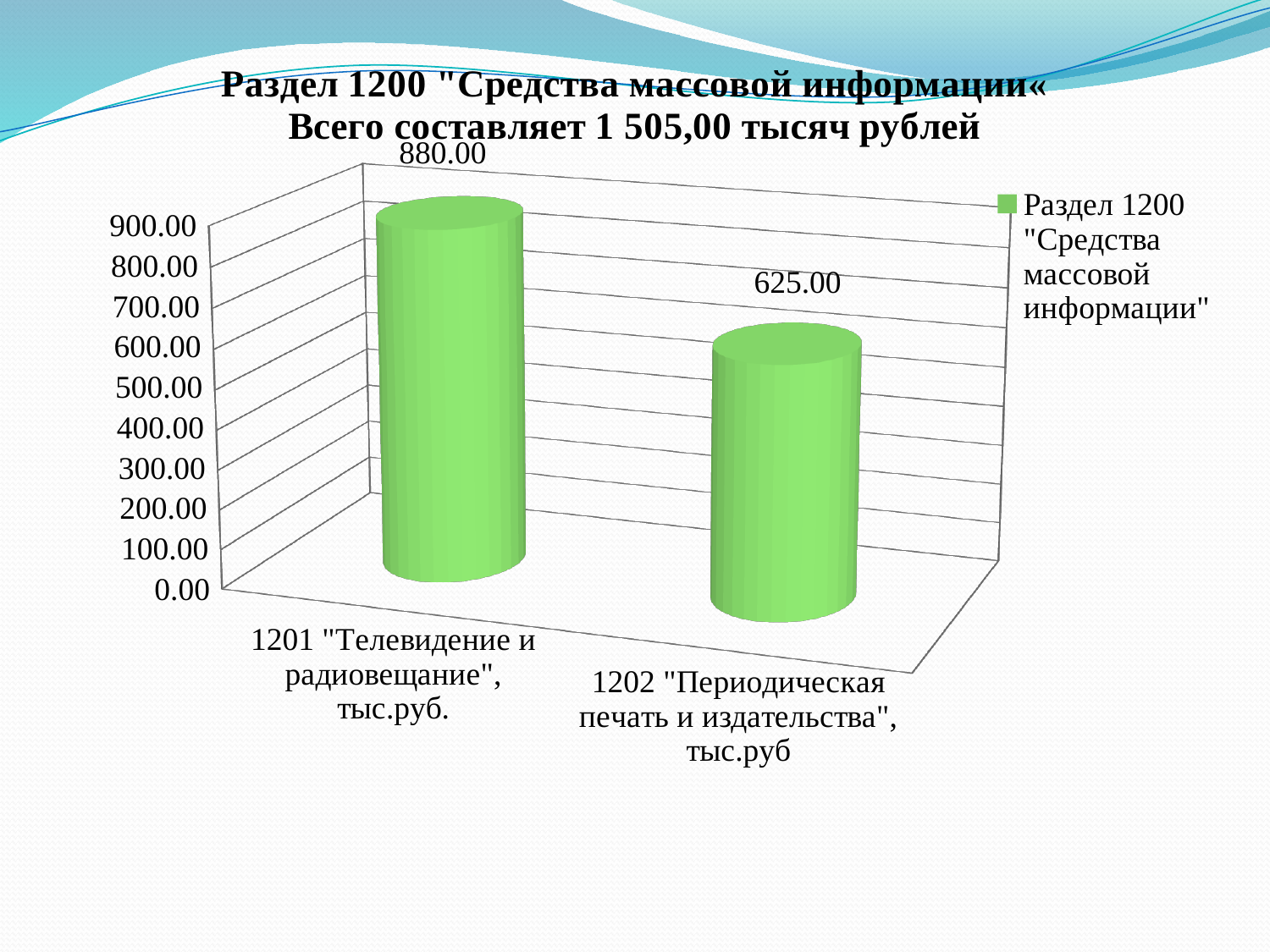
What is the value for 1202 "Периодическая печать и издательства"? 625.00 Is the value for 1201 "Телевидение и радиовещание" greater or less than 800.00? greater What is the name of the series in the legend? Раздел 1200 "Средства массовой информации" Is the value for 1202 "Периодическая печать и издательства" greater or less than 700.00? less What is the difference between the values for 1201 "Телевидение и радиовещание" and 1202 "Периодическая печать и издательства"? 255.00 How many series does the legend list? 1 What kind of chart is shown on the slide? bar chart How many categories are shown in the chart? 2 Which is larger: the value for 1201 "Телевидение и радиовещание" or for 1202 "Периодическая печать и издательства"? 1201 "Телевидение и радиовещание" What is the value for 1201 "Телевидение и радиовещание"? 880.00 Which category has the highest value? 1201 "Телевидение и радиовещание" Which category has the lowest value? 1202 "Периодическая печать и издательства"